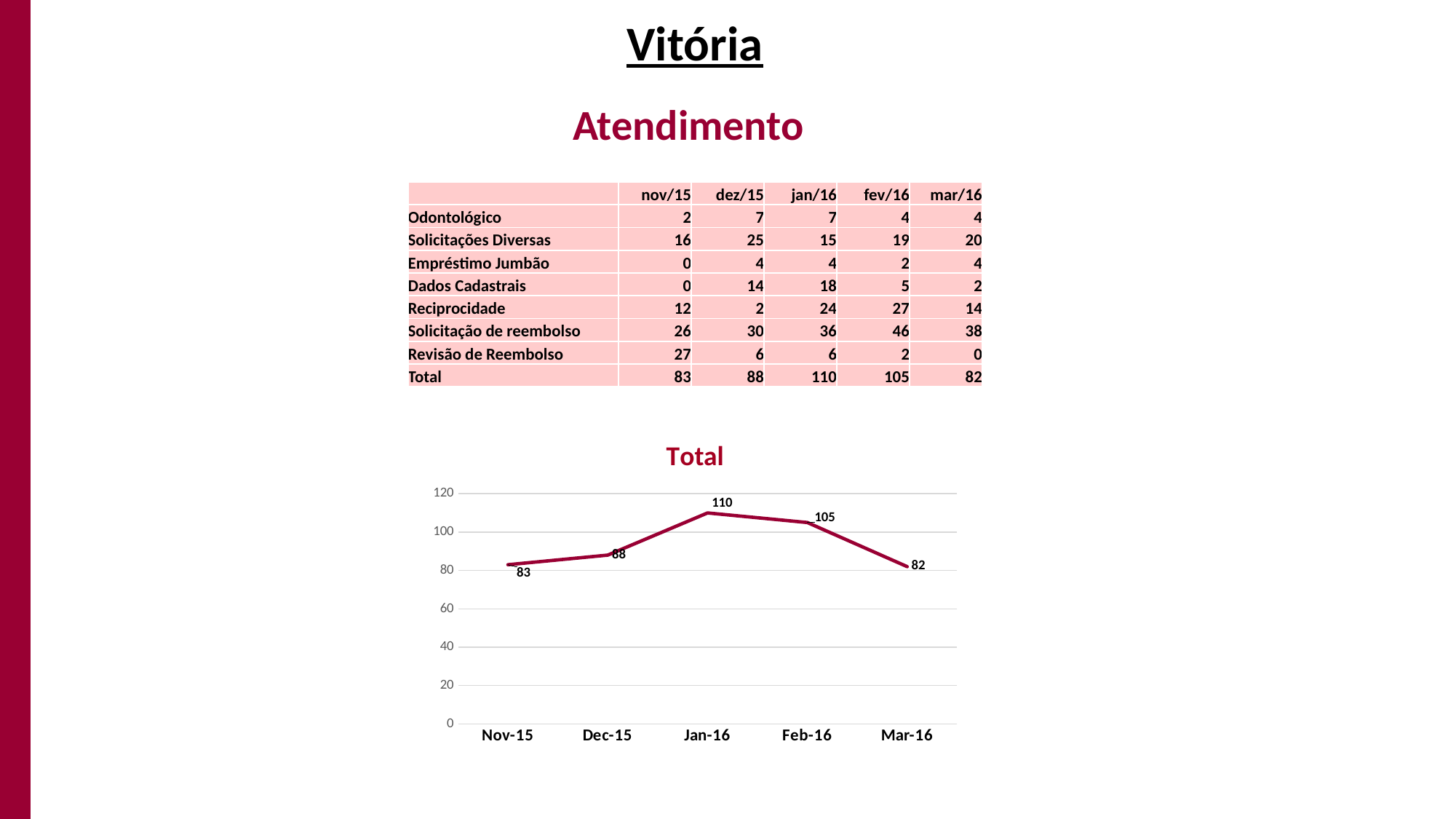
What is the value for Jan-16 in the Total chart? 110 How many months are plotted in the Total chart? 5 Is the value for Feb-16 in the Total chart greater or less than 100? greater What is the value for Mar-16 in the Total chart? 82 What is the value for Nov-15 in the Total chart? 83 What kind of chart is the Total chart? line chart Which month has the lowest value in the Total chart? Mar-16 Which is larger in the Total chart, the value for Feb-16 or the value for Dec-15? Feb-16 What is the title of the chart on the slide? Total What is the difference between the Jan-16 and Feb-16 values in the Total chart? 5 What is the difference between the Dec-15 and Nov-15 values in the Total chart? 5 Which month has the highest value in the Total chart? Jan-16